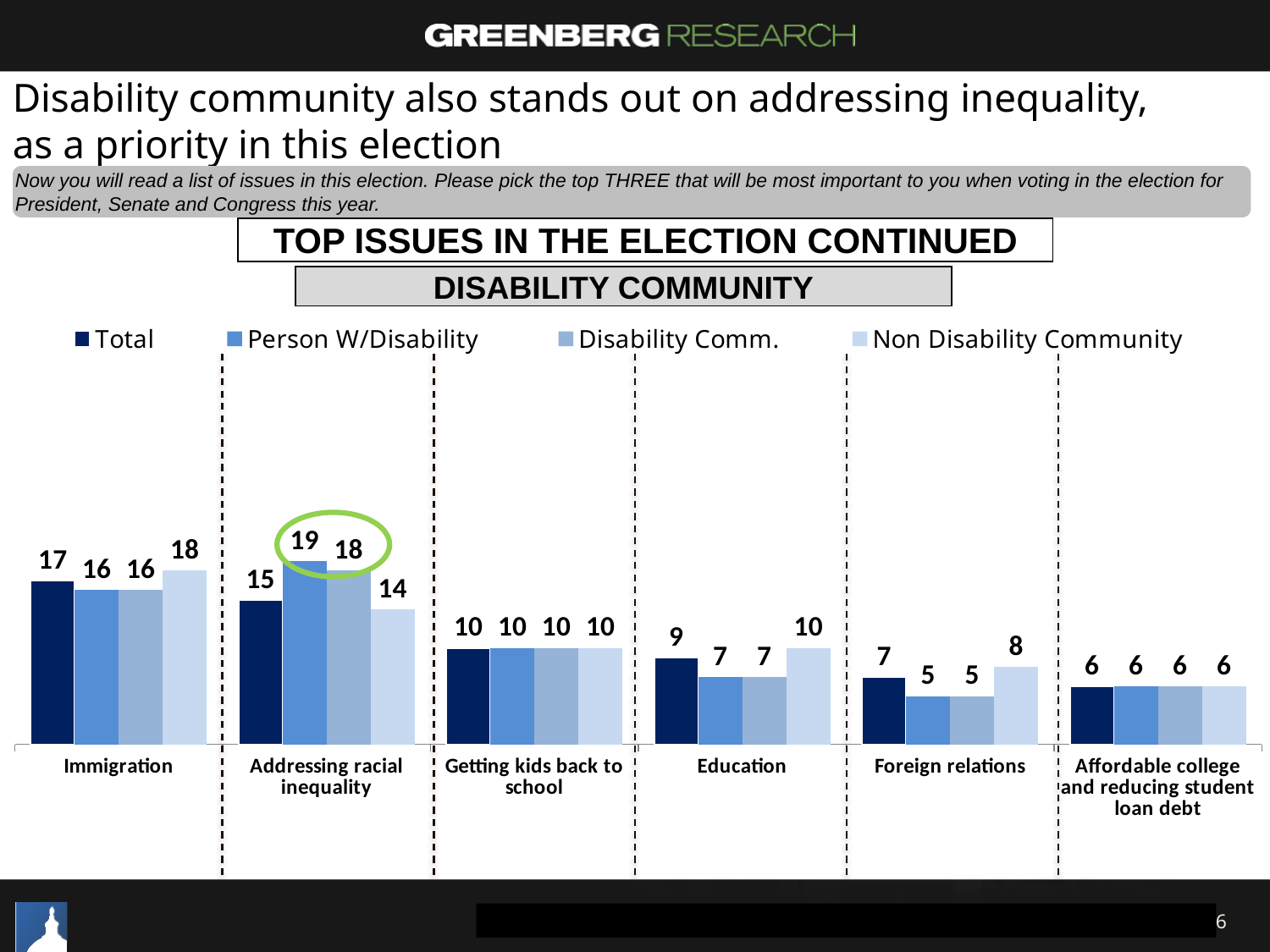
What is the value for Person W/Disability for Addressing racial inequality? 19 Which category has the lowest value for the Person W/Disability series? Foreign relations Which category has the highest value for the Total series? Immigration Which is larger for Foreign relations: the Total value or the Non Disability Community value? Non Disability Community What kind of chart is shown on the slide? Bar chart How many categories are shown on the x axis? 6 What is the value for Non Disability Community for Education? 10 Which category's bars are circled in green on the chart? Addressing racial inequality What is the value for Total for Immigration? 17 What is the value for Disability Comm. for Foreign relations? 5 What is the difference between the Person W/Disability and Non Disability Community values for Addressing racial inequality? 5 How many series does the legend list? 4